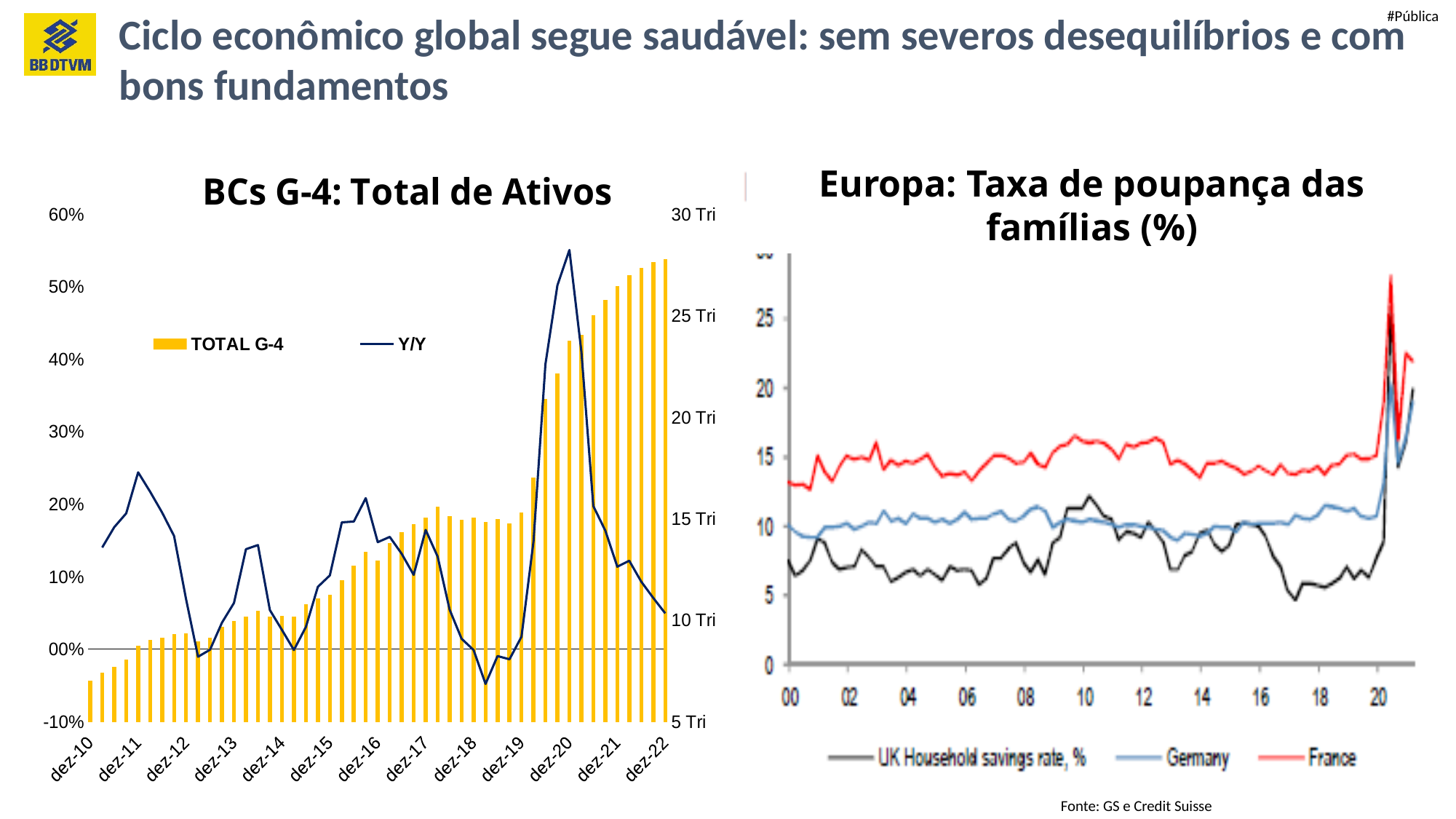
On the chart 'Europa: Taxa de poupança das famílias (%)', how many series does the legend list? 3 On the chart 'BCs G-4: Total de Ativos', is the Y/Y value at dez-20 greater or less than 40%? greater On the chart 'BCs G-4: Total de Ativos', how many series does the legend list? 2 On the chart 'BCs G-4: Total de Ativos', what are the two legend entries? TOTAL G-4 and Y/Y On the chart 'Europa: Taxa de poupança das famílias (%)', which series is generally the lowest over the period shown? UK Household savings rate, % On the chart 'Europa: Taxa de poupança das famílias (%)', what kind of chart is shown? line chart On the chart 'BCs G-4: Total de Ativos', does the Y/Y line rise or fall from dez-20 to dez-22? fall On the chart 'BCs G-4: Total de Ativos', is the TOTAL G-4 value for dez-22 greater or less than 25 Tri? greater On the chart 'BCs G-4: Total de Ativos', is the TOTAL G-4 value for dez-10 greater or less than 10 Tri? less On the chart 'BCs G-4: Total de Ativos', do the TOTAL G-4 bars generally rise or fall from dez-10 to dez-22? rise On the chart 'BCs G-4: Total de Ativos', what kind of chart is used for the TOTAL G-4 series? bar chart